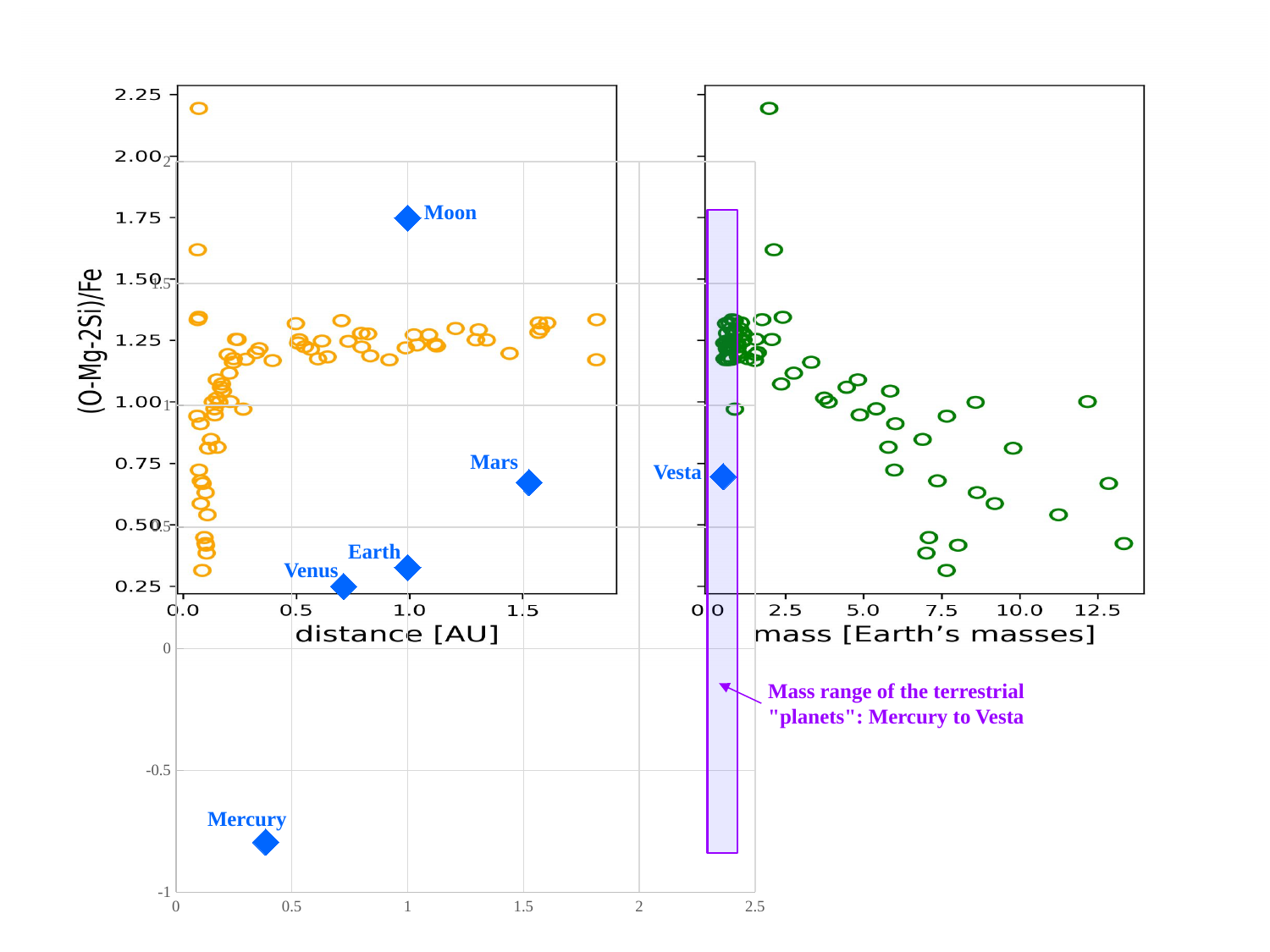
In the left chart (distance [AU]), is the (O-Mg-2Si)/Fe value for the Moon greater or less than 1.50? greater In the left chart (distance [AU]), which has the higher (O-Mg-2Si)/Fe value, the Moon or Mars? Moon In the left chart (distance [AU]), which has the higher (O-Mg-2Si)/Fe value, Mars or Earth? Mars What kind of chart is the left chart with the x axis 'distance [AU]'? scatter chart In the left chart (distance [AU]), which labelled body has the highest (O-Mg-2Si)/Fe value? Moon What is the x-axis title of the right chart? mass [Earth's masses] In the left chart (distance [AU]), is the (O-Mg-2Si)/Fe value for Earth greater or less than 0.50? less How many labelled blue diamond points are shown in the left chart (distance [AU])? 5 What does the purple annotation on the right chart say the shaded rectangle represents? Mass range of the terrestrial "planets": Mercury to Vesta In the right chart (mass [Earth's masses]), is the (O-Mg-2Si)/Fe value for Vesta greater or less than 1.00? less In the left chart (distance [AU]), which labelled body has the lowest (O-Mg-2Si)/Fe value? Mercury